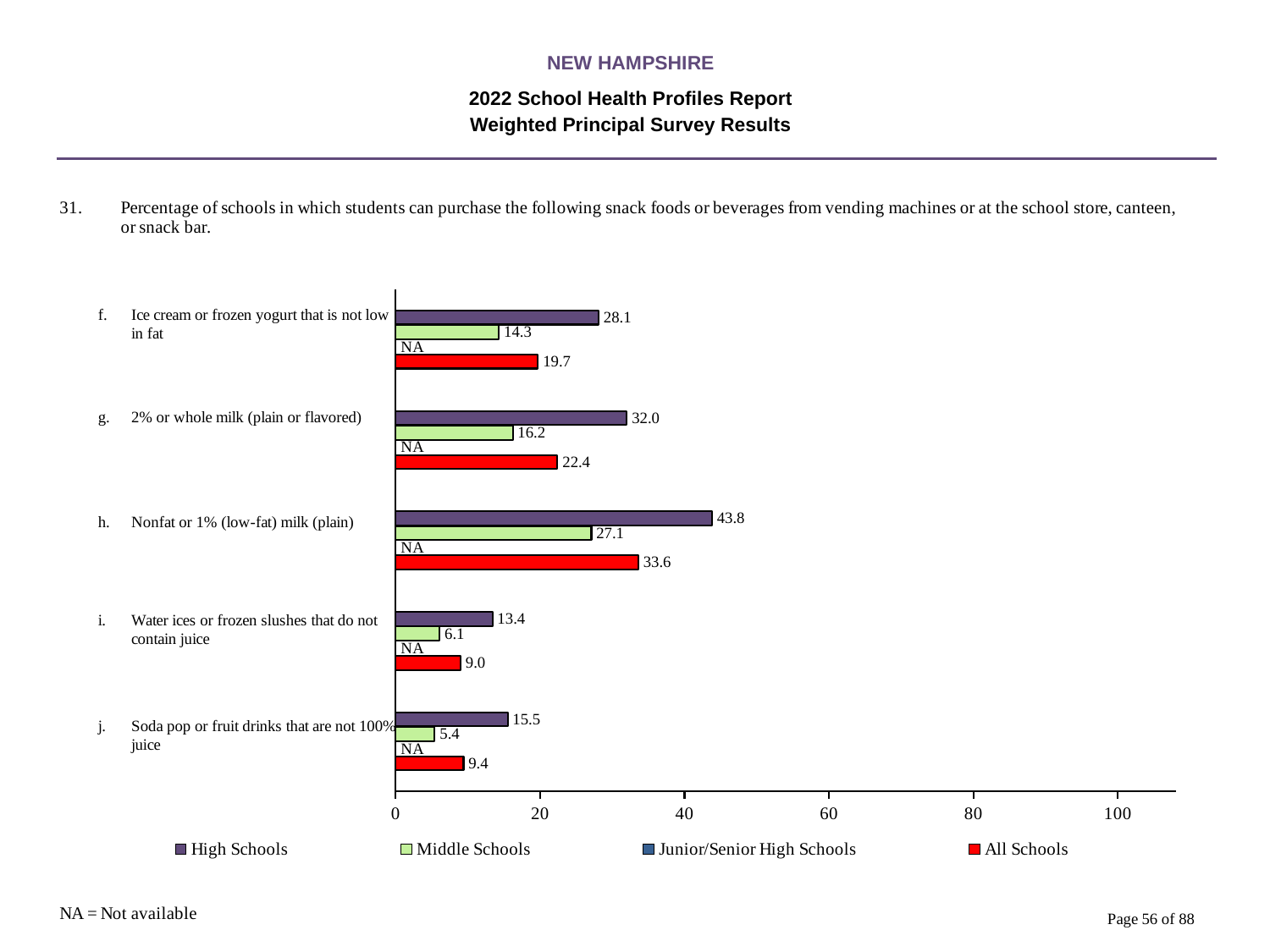
What is the difference between the High Schools and Middle Schools values for 'Ice cream or frozen yogurt that is not low in fat'? 13.8 What is the All Schools value for 'Soda pop or fruit drinks that are not 100% juice'? 9.4 How many series does the legend list? 4 What kind of chart is shown on the slide? bar chart What is the High Schools value for 'Nonfat or 1% (low-fat) milk (plain)'? 43.8 Which category has the lowest Middle Schools value? Soda pop or fruit drinks that are not 100% juice Which category has the highest High Schools value? Nonfat or 1% (low-fat) milk (plain) What value is shown for the Junior/Senior High Schools series in every category? NA What is the Middle Schools value for '2% or whole milk (plain or flavored)'? 16.2 Which is larger: the All Schools value for 'Water ices or frozen slushes that do not contain juice' or the All Schools value for 'Soda pop or fruit drinks that are not 100% juice'? Soda pop or fruit drinks that are not 100% juice Is the High Schools value for '2% or whole milk (plain or flavored)' greater or less than 40? less How many snack food or beverage categories are shown on the chart? 5